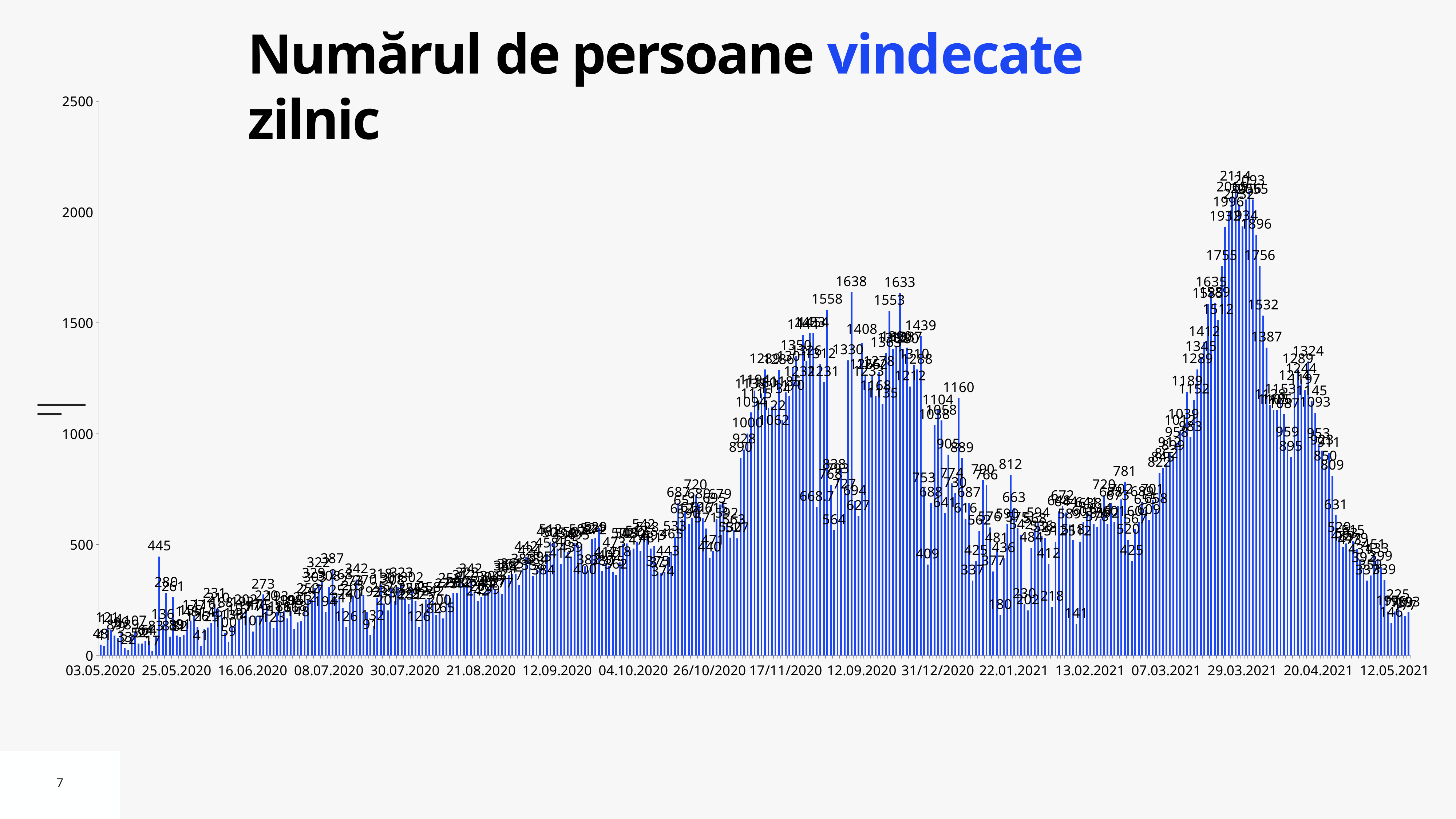
What is the highest tick value shown on the vertical axis? 2500 Is the value for 17/11/2020 greater or less than 1000? greater Is the value for 03.05.2020 greater or less than 500? less Is the value for 22.01.2021 greater or less than 1000? less What is the highest daily value labelled on the chart? 2114 What kind of chart is shown on the slide? bar chart Do the values rise or fall between 13.02.2021 and 29.03.2021? rise What is the title of the chart? Numărul de persoane vindecate zilnic Do the values rise or fall between 29.03.2021 and 12.05.2021? fall